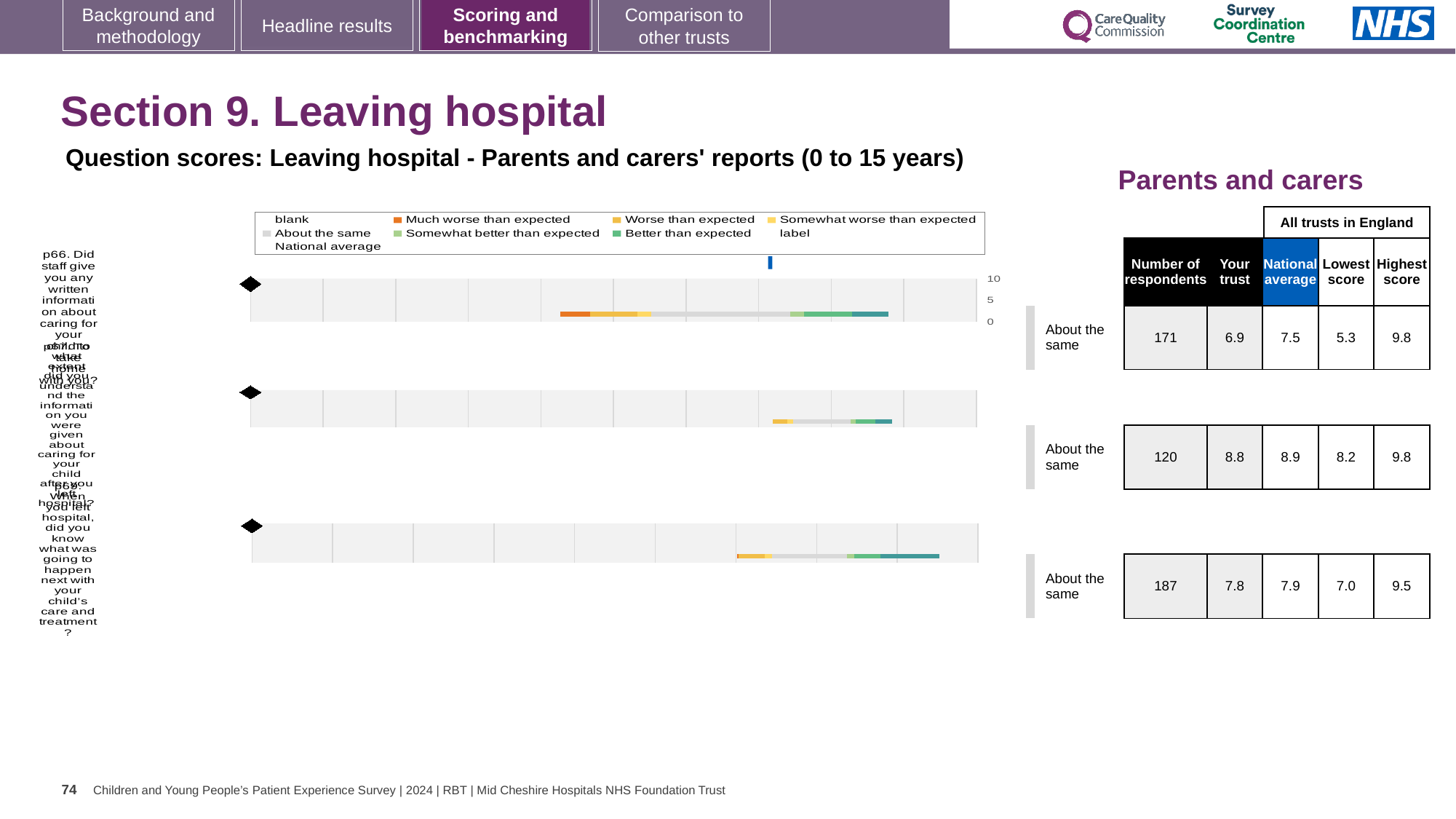
For the middle chart, what is the national average score shown beside it? 8.9 What benchmark category is shown beside each of the three charts? About the same Which chart (top, middle or bottom) has the lowest number of respondents? Middle For the top chart, which is larger: the 'Your trust' score or the national average? National average For the bottom chart, how many respondents are listed beside it? 187 Which chart (top, middle or bottom) has the highest 'Your trust' score? Middle What kind of chart is used to show the benchmarking results on this slide? Bar chart For the top chart, what is the difference between the highest score and the lowest score across all trusts in England? 4.5 For the bottom chart, what is the lowest score across all trusts in England? 7.0 In the legend, what colour represents 'Much worse than expected'? Orange For the top chart, what is the 'Your trust' score shown in the table row beside it? 6.9 How many question charts are shown on the slide? 3